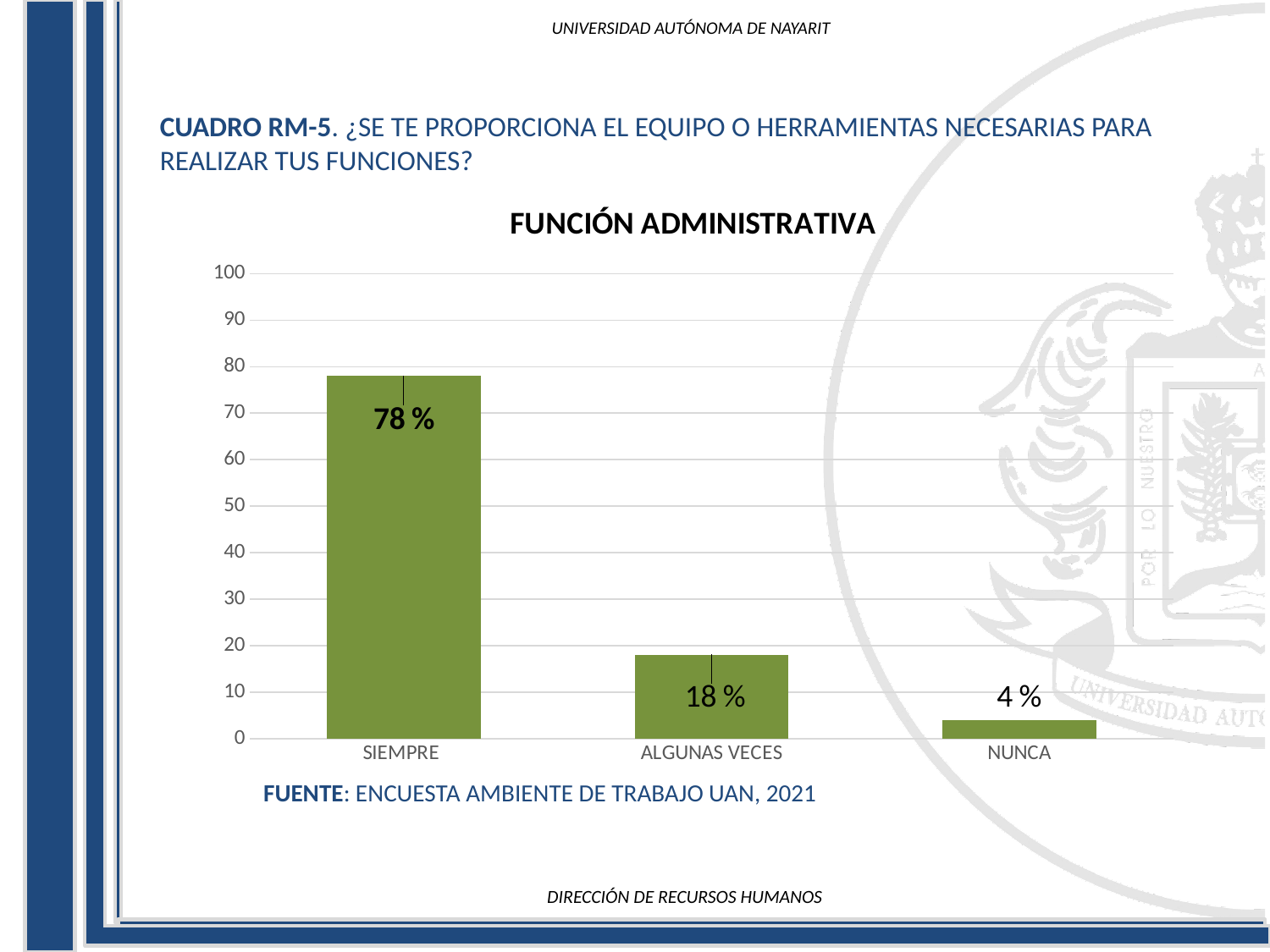
What is the value for NUNCA? 4 % Which is larger, the value for ALGUNAS VECES or the value for NUNCA? ALGUNAS VECES Which category has the lowest value? NUNCA What is the difference between the values for ALGUNAS VECES and NUNCA? 14 % What is the value for ALGUNAS VECES? 18 % What is the difference between the values for SIEMPRE and ALGUNAS VECES? 60 % What is the title of the chart? FUNCIÓN ADMINISTRATIVA What is the value for SIEMPRE? 78 % How many categories are shown on the x axis? 3 Which category has the highest value? SIEMPRE What kind of chart is shown? bar chart Is the value for SIEMPRE greater or less than 70? greater